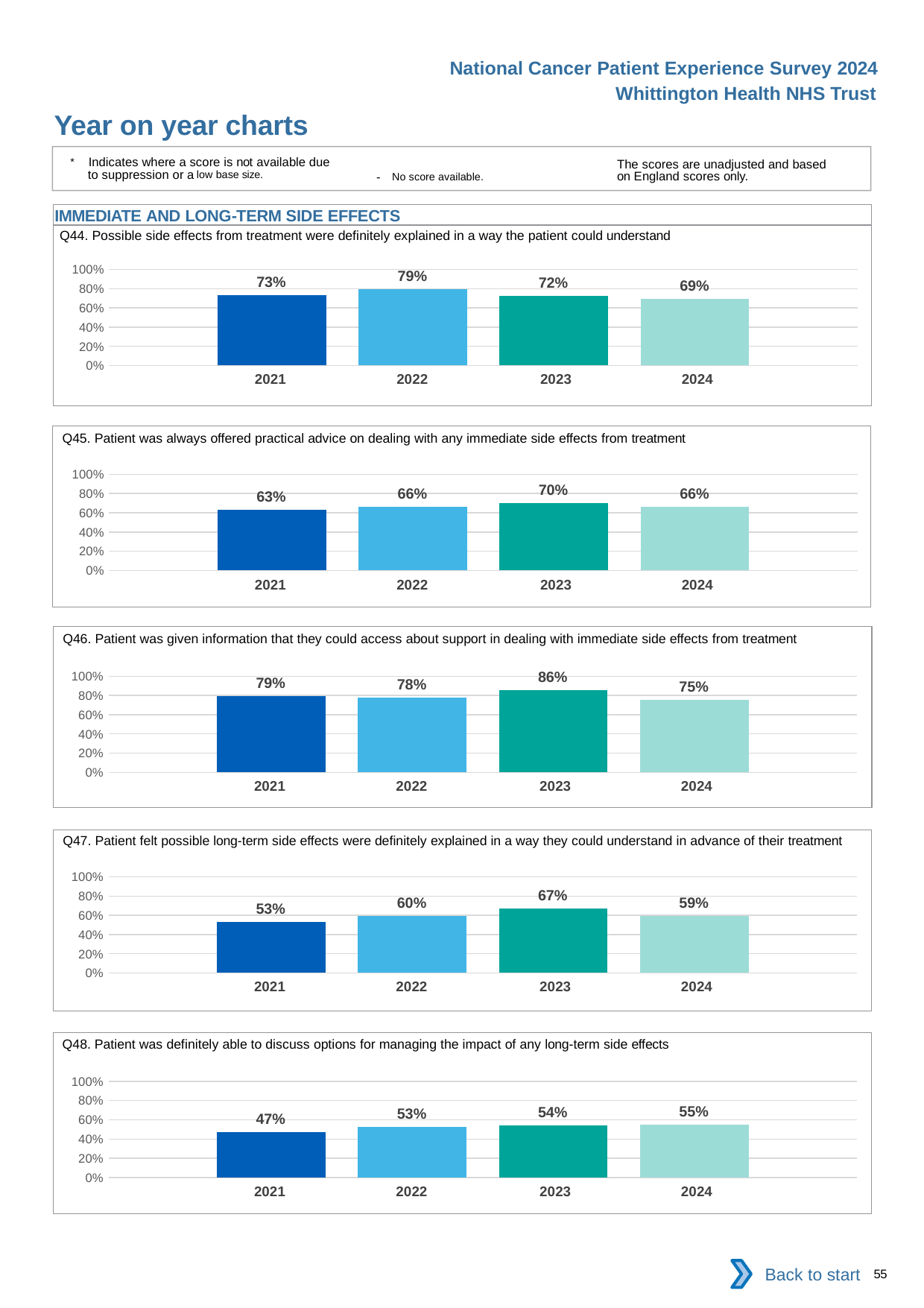
In the Q48 chart, do the values rise or fall from 2021 to 2024? rise How many years are shown in the Q48 chart? 4 In the Q44 chart, what is the value for 2022? 79% What kind of chart is the Q44 chart? bar chart In the Q45 chart, which year has the highest value? 2023 In the Q47 chart, what is the difference between the 2023 and 2024 values? 8 percentage points In the Q48 chart, is the value for 2021 greater or less than 60%? less In the Q44 chart, which year has the lowest value? 2024 In the Q45 chart, what is the difference between the 2023 and 2021 values? 7 percentage points In the Q47 chart, what is the value for 2021? 53% In the Q46 chart, what is the value for 2023? 86% In the Q46 chart, which is larger, the value for 2021 or the value for 2024? 2021